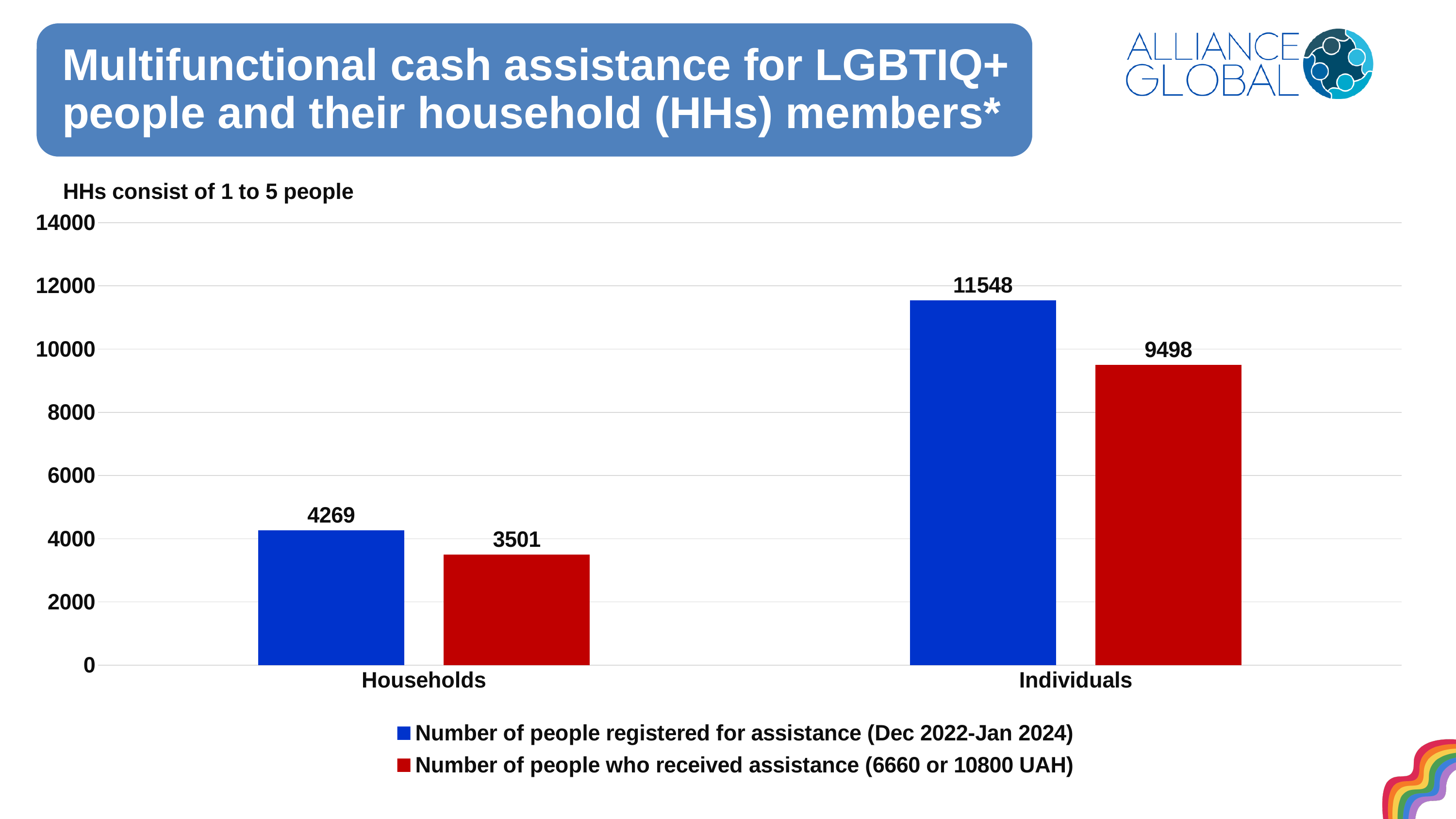
What is the difference between the number of people registered for assistance and the number who received assistance for Individuals? 2050 What is the number of people registered for assistance for Individuals? 11548 How many categories are shown on the x axis? 2 What is the difference between the number of people registered for assistance and the number who received assistance for Households? 768 What is the number of people registered for assistance for Households? 4269 What is the number of people who received assistance for Individuals? 9498 What is the number of people who received assistance for Households? 3501 Which is larger for Households: the number of people registered for assistance or the number who received assistance? Number of people registered for assistance Which category has the highest value for the number of people registered for assistance? Individuals What kind of chart is shown on the slide? Bar chart Which category has the lowest value for the number of people who received assistance? Households How many series does the legend list? 2